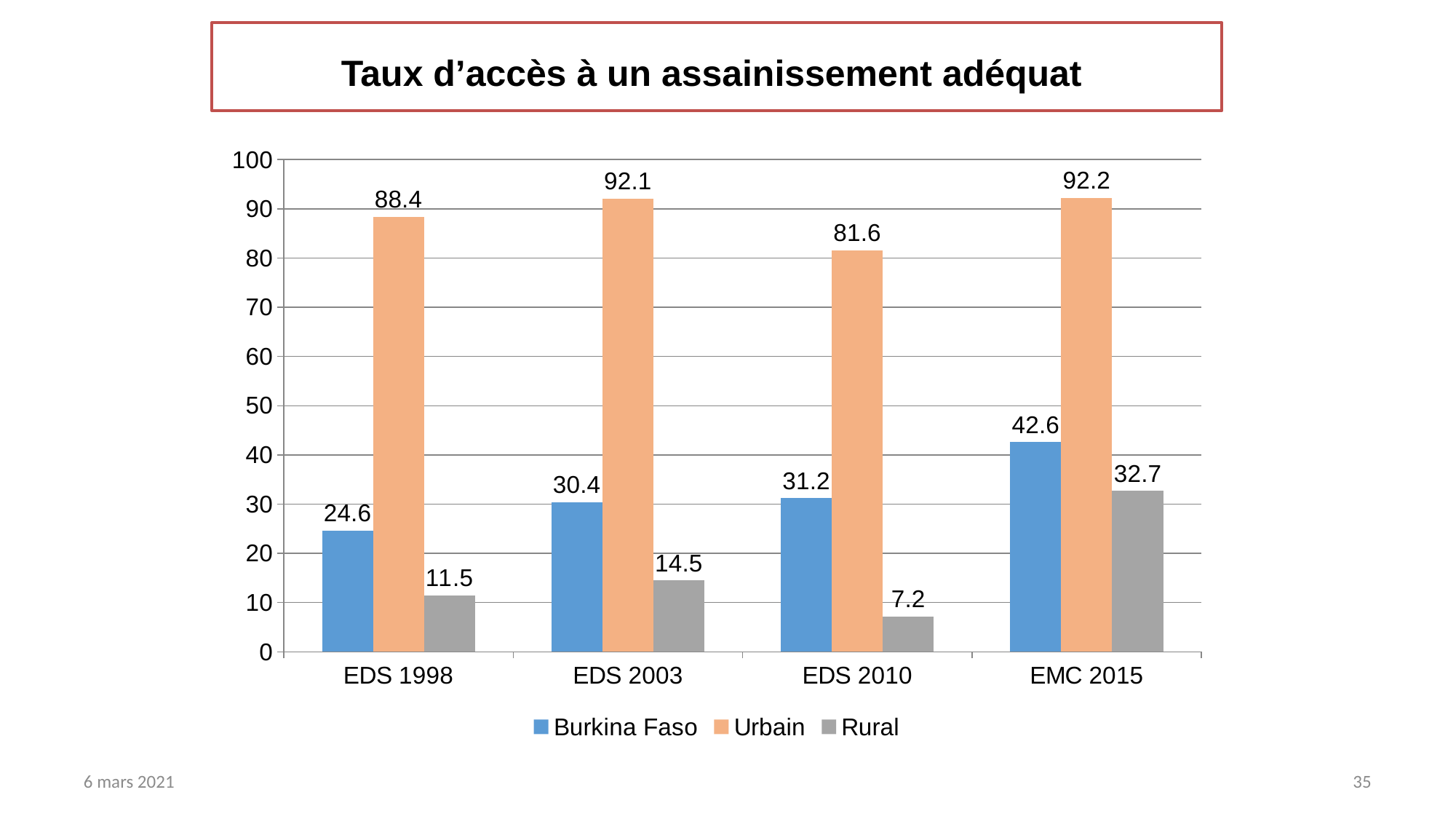
What is the Urbain value for EDS 2003? 92.1 What is the Burkina Faso value for EMC 2015? 42.6 How many series does the legend list? 3 Does the Burkina Faso series rise or fall from EDS 1998 to EMC 2015? rise What is the difference between the Urbain and Rural values for EDS 1998? 76.9 How many categories are shown on the x axis? 4 What is the Rural value for EDS 2010? 7.2 Which category has the lowest Urbain value? EDS 2010 Which category has the highest Rural value? EMC 2015 Which is larger: the Burkina Faso value for EDS 2003 or for EDS 2010? EDS 2010 What kind of chart is shown on the slide? bar chart What is the title of the chart? Taux d’accès à un assainissement adéquat